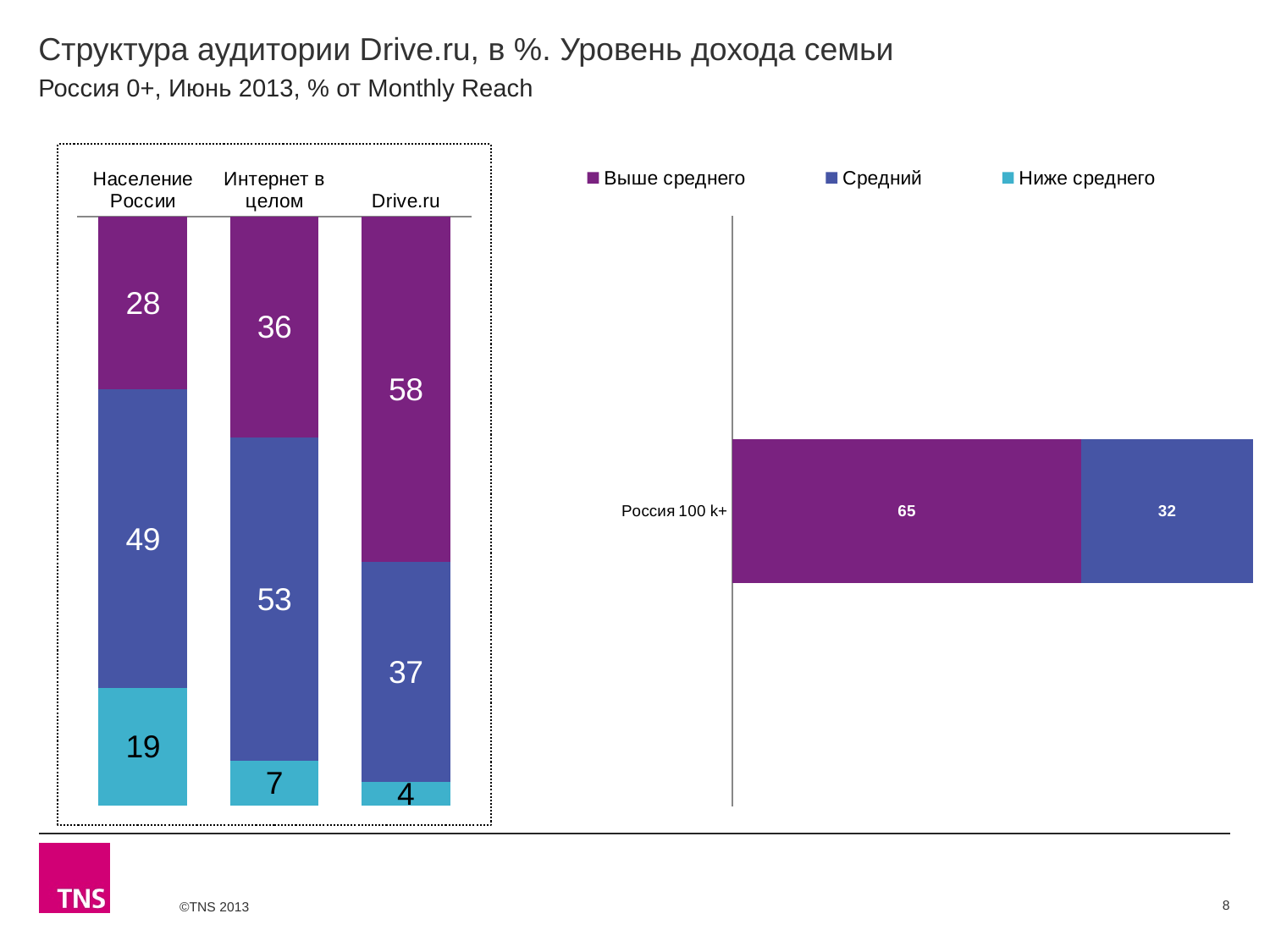
In the left chart, what is the value of Выше среднего for Drive.ru? 58 In the left chart, what is the difference between the Выше среднего values for Drive.ru and Население России? 30 In the left chart, which category has the lowest value for Ниже среднего? Drive.ru In the right chart, what is the difference between the Выше среднего and Средний values for Россия 100 k+? 33 In the left chart, which is larger: Средний for Население России or Средний for Drive.ru? Население России How many categories are shown on the x axis of the left chart? 3 How many series does the legend list? 3 What kind of chart is the left chart? Stacked bar chart In the right chart, what is the value of Выше среднего for Россия 100 k+? 65 In the left chart, what is the value of Ниже среднего for Население России? 19 In the left chart, what is the value of Средний for Интернет в целом? 53 In the left chart, which category has the highest value for Выше среднего? Drive.ru